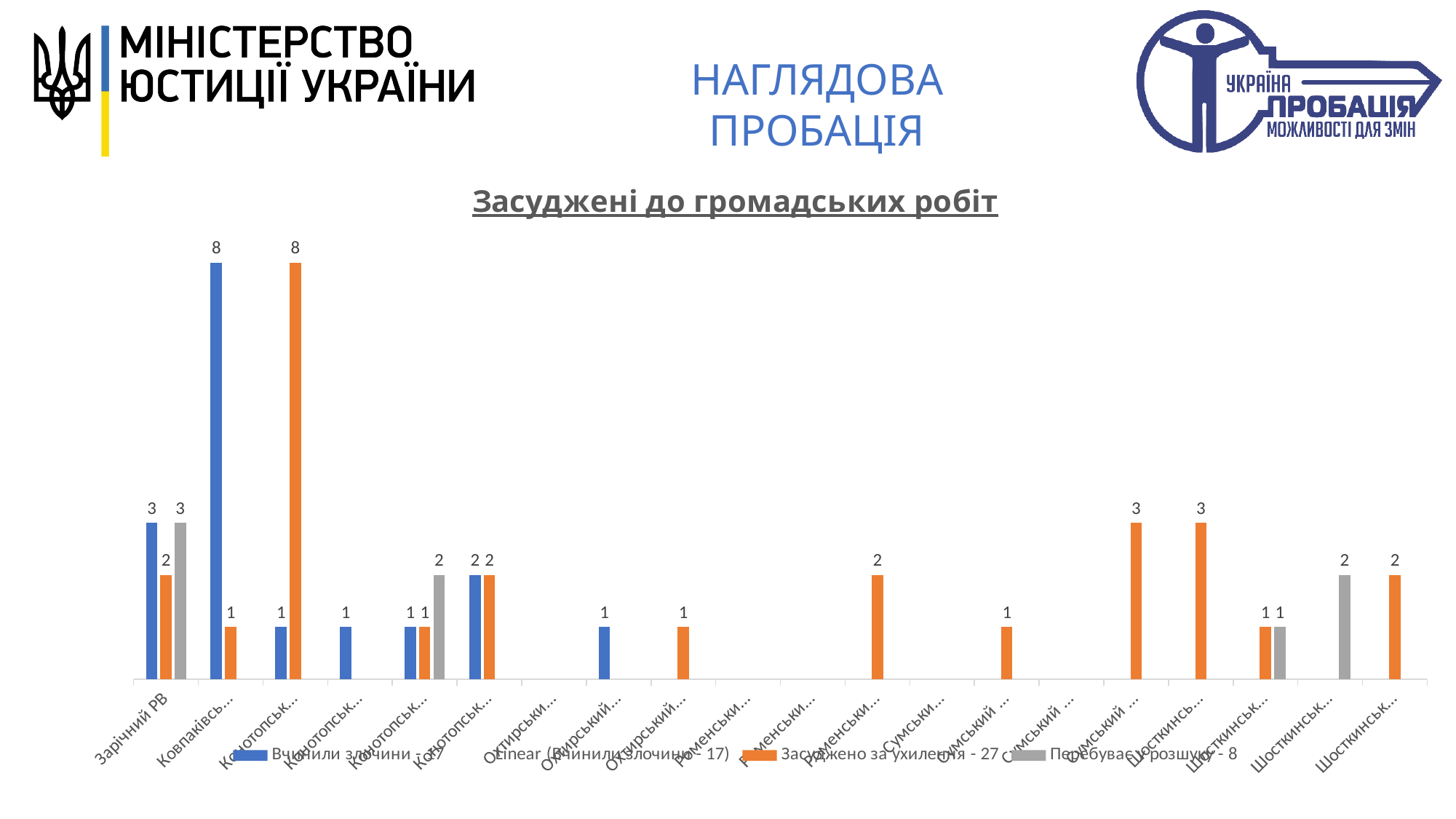
What is the value of the series 'Перебуває у розшуку - 8' for Зарічний РВ? 3 For Зарічний РВ, what is the difference between 'Вчинили злочини - 17' and 'Засуджено за ухилення - 27'? 1 What is the title of the chart? Засуджені до громадських робіт What is the value of the series 'Засуджено за ухилення - 27' for Зарічний РВ? 2 What kind of chart is shown on the slide? bar chart How many entries does the chart legend list? 4 What is the value of the series 'Вчинили злочини - 17' for Зарічний РВ? 3 Which category has the highest value for the series 'Перебуває у розшуку - 8'? Зарічний РВ What is the highest value shown for the series 'Засуджено за ухилення - 27'? 8 What is the highest value shown for the series 'Вчинили злочини - 17'? 8 For Зарічний РВ, which is larger: 'Вчинили злочини - 17' or 'Засуджено за ухилення - 27'? Вчинили злочини - 17 How many categories are shown along the x axis of the chart? 20